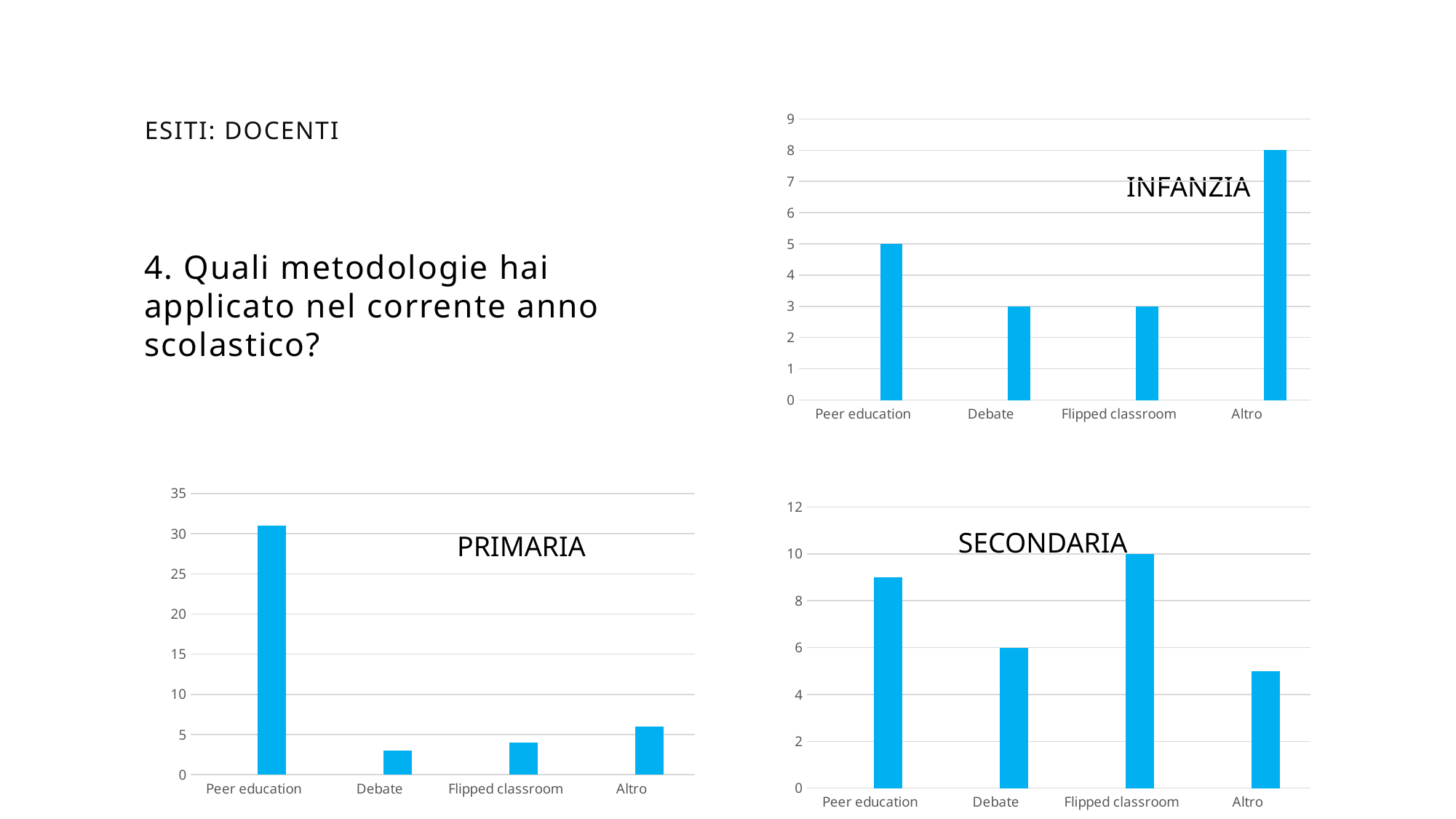
In the SECONDARIA chart, what is the value for Flipped classroom? 10 In the INFANZIA chart, what is the difference between the values for Altro and Peer education? 3 In the SECONDARIA chart, what is the value for Debate? 6 How many categories are shown on the x axis of the PRIMARIA chart? 4 In the SECONDARIA chart, which category has the lowest value? Altro In the PRIMARIA chart, which is larger, the value for Altro or the value for Debate? Altro In the INFANZIA chart, which category has the highest value? Altro In the PRIMARIA chart, which category has the highest value? Peer education In the INFANZIA chart, what is the value for Peer education? 5 In the PRIMARIA chart, is the value for Peer education greater or less than 30? greater In the SECONDARIA chart, is the value for Peer education greater or less than 8? greater In the INFANZIA chart, what is the value for Altro? 8